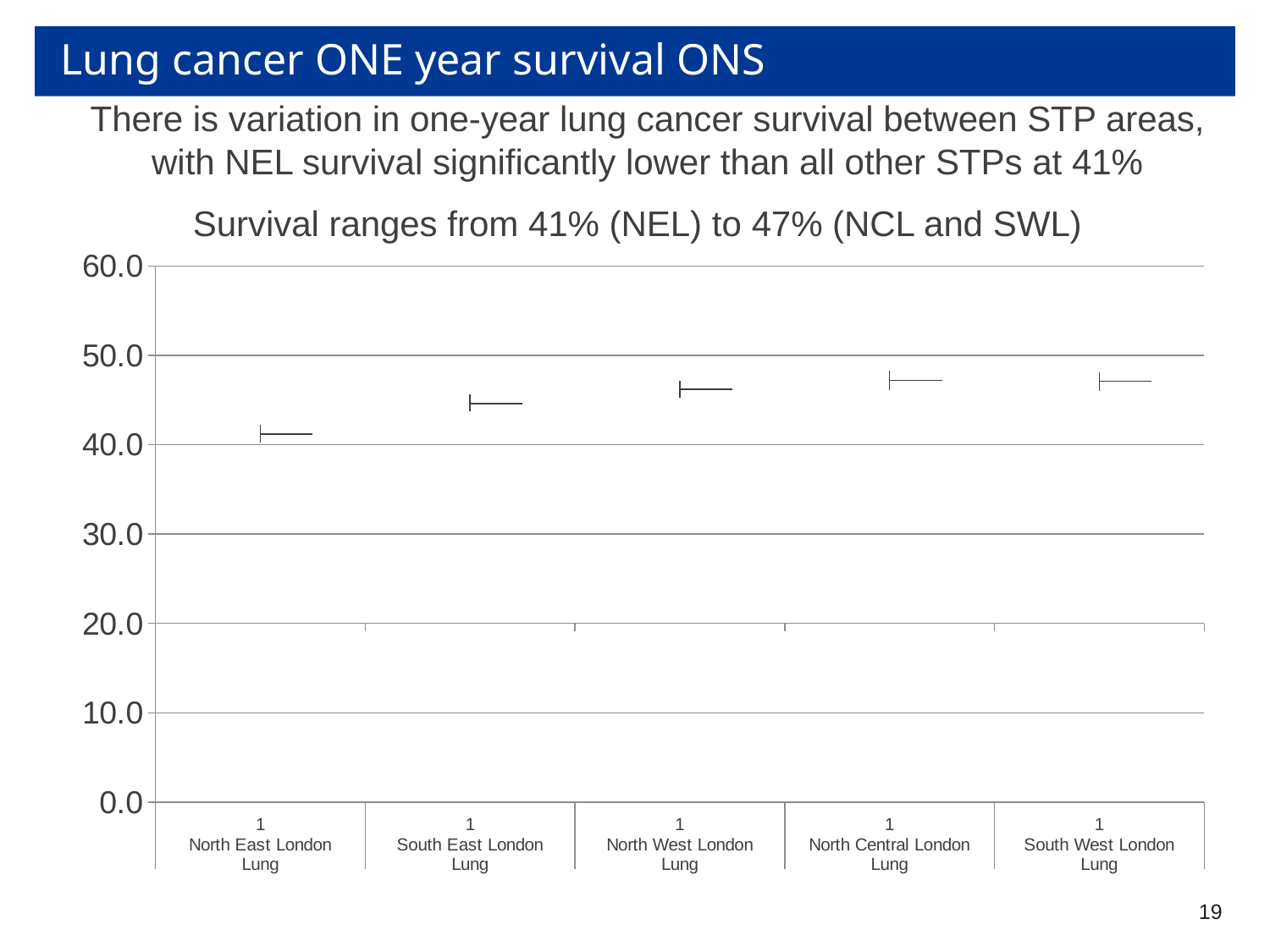
Which is larger, the value for North East London or the value for South East London? South East London Which is larger, the value for North East London or the value for North Central London? North Central London Is the value for South West London greater or less than 40? greater Do the plotted values generally rise or fall moving from left to right along the x axis? rise Is the value for North Central London greater or less than 40? greater Is the value for North East London greater or less than 50? less Which STP area has the lowest one-year lung cancer survival in the chart? North East London How many STP areas are plotted on the x axis of the chart? 5 What is the highest value shown on the y axis of the chart? 60.0